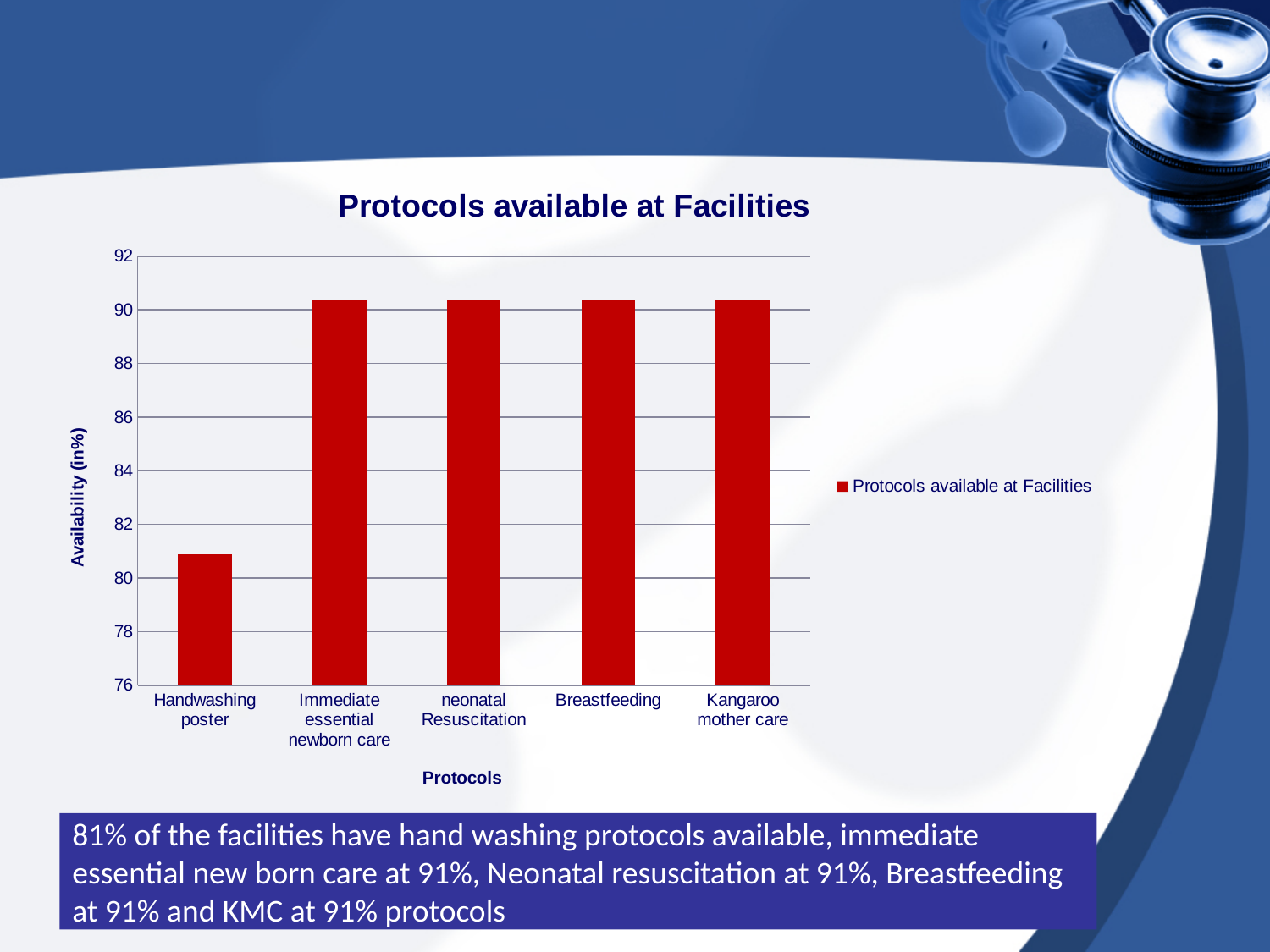
What is the title of the chart? Protocols available at Facilities What kind of chart is shown on the slide? bar chart What is the label of the vertical axis? Availability (in%) Is the value for Kangaroo mother care greater or less than 92? less Is the value for Handwashing poster greater or less than 80? greater Is the value for Handwashing poster greater or less than 82? less How many series does the legend list? 1 How many protocol categories are plotted on the x axis? 5 Which is larger, the value for Immediate essential newborn care or the value for Handwashing poster? Immediate essential newborn care Which protocol has the lowest availability? Handwashing poster